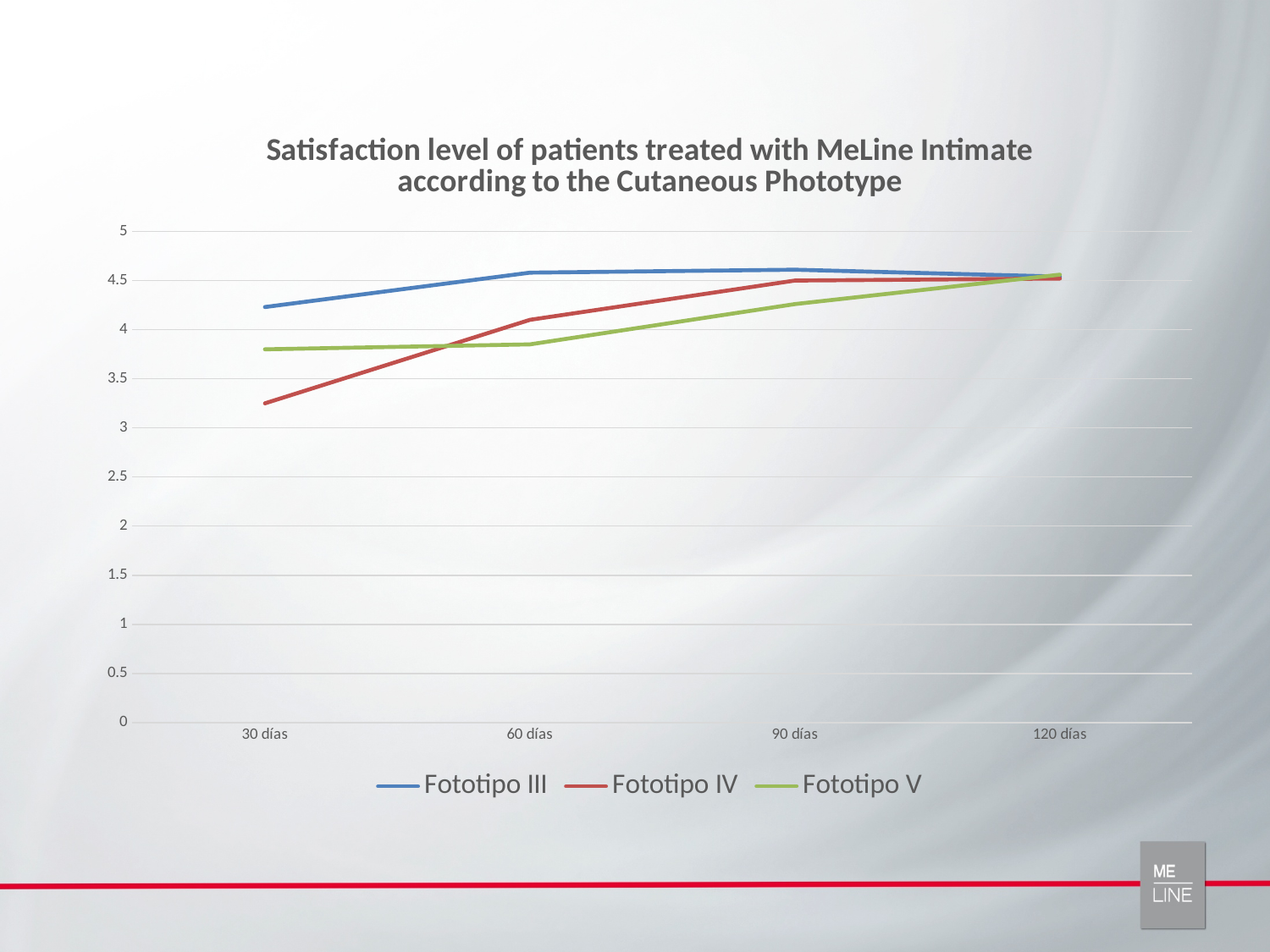
Is the value for Fototipo III at 60 días greater or less than 4.5? greater At 60 días, which is larger: the value for Fototipo IV or the value for Fototipo V? Fototipo IV How many series does the legend list? 3 Is the value for Fototipo V at 60 días greater or less than 4? less Does the value for Fototipo IV rise or fall from 30 días to 120 días? rise Which series is drawn in green? Fototipo V What kind of chart is shown on the slide? line chart What is the title of the chart? Satisfaction level of patients treated with MeLine Intimate according to the Cutaneous Phototype Which series has the lowest value at 30 días? Fototipo IV How many time points are shown on the x axis? 4 Is the value for Fototipo IV at 30 días greater or less than 3.5? less Which series has the highest value at 30 días? Fototipo III